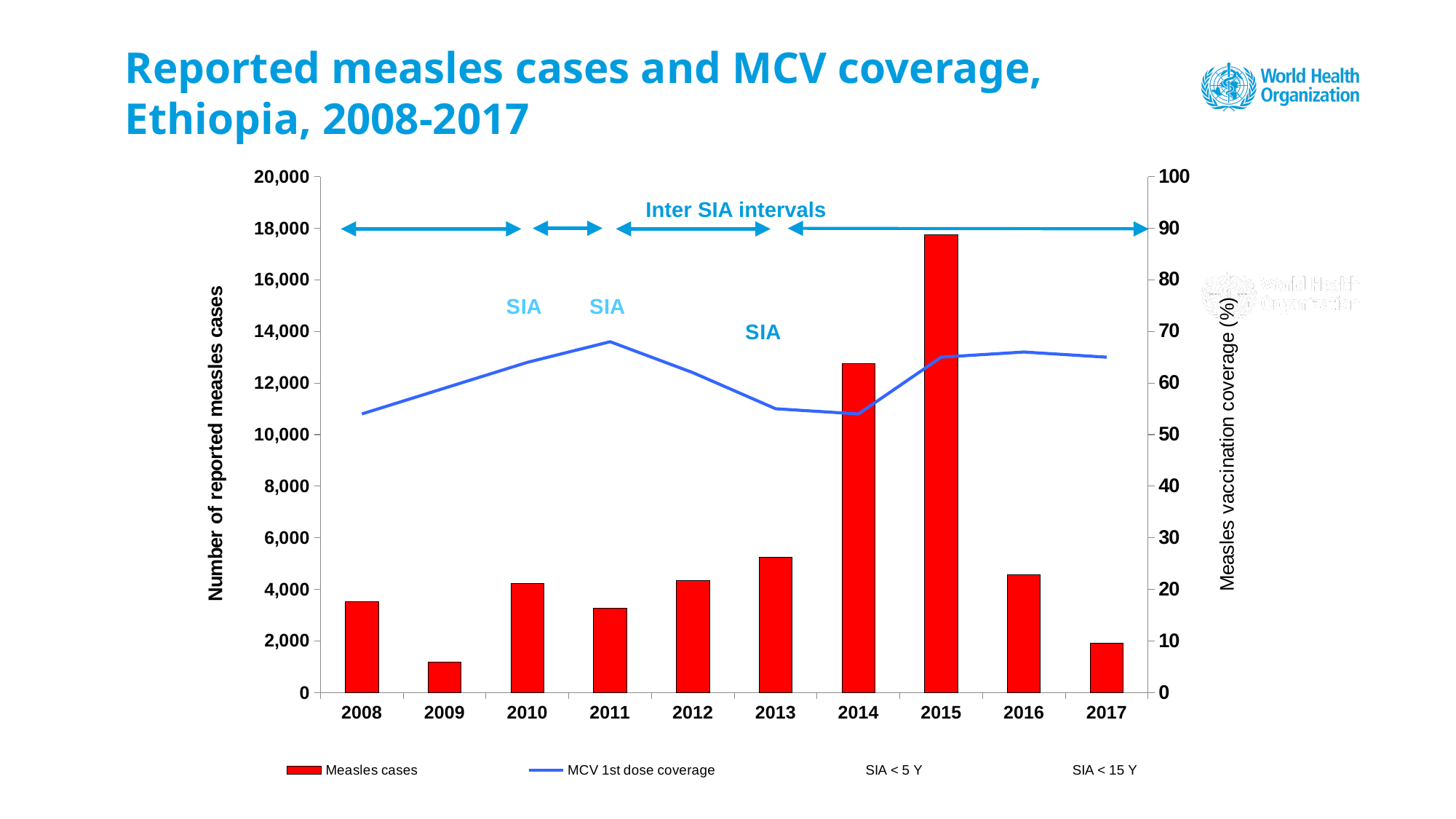
Is the number of reported measles cases in 2015 greater or less than 16,000? greater Which year had more reported measles cases, 2017 or 2016? 2016 Is the MCV 1st dose coverage in 2011 greater or less than 60%? greater Which year has the highest number of reported measles cases? 2015 Is the number of reported measles cases in 2014 greater or less than 12,000? greater How many years are shown on the x axis of the chart? 10 Which year had more reported measles cases, 2014 or 2013? 2014 Did the MCV 1st dose coverage rise or fall from 2011 to 2013? fall Which year has the lowest number of reported measles cases? 2009 How many entries does the chart legend list? 4